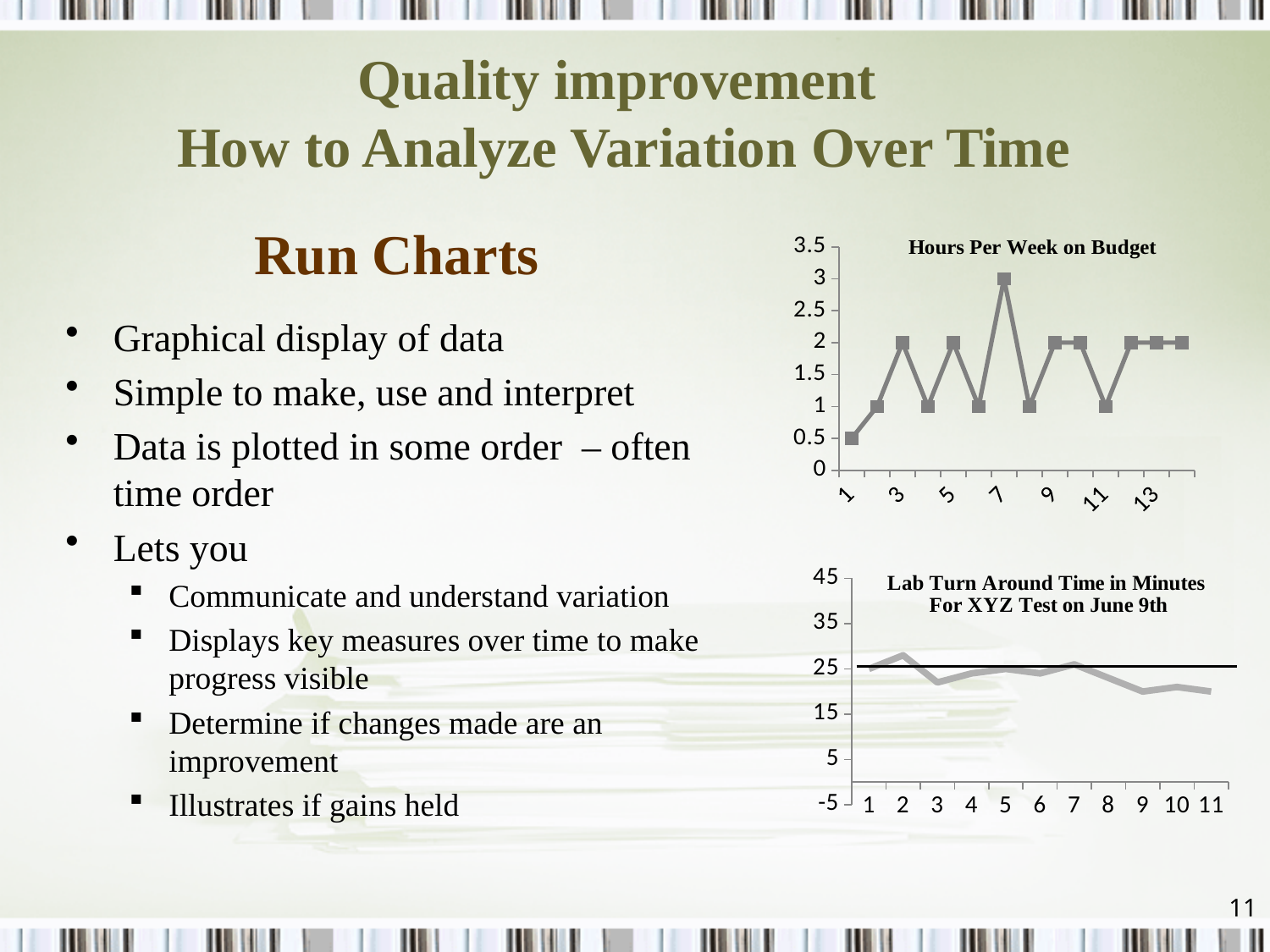
In the "Hours Per Week on Budget" chart, which point has the highest value? 7 In the "Lab Turn Around Time in Minutes For XYZ Test on June 9th" chart, is the value at point 9 greater or less than 25? less In the "Hours Per Week on Budget" chart, what is the value at point 3? 2 How many data points are plotted in the "Hours Per Week on Budget" chart? 14 In the "Hours Per Week on Budget" chart, is the value at point 5 larger or smaller than the value at point 6? larger In the "Lab Turn Around Time in Minutes For XYZ Test on June 9th" chart, which point has the highest value? 2 In the "Hours Per Week on Budget" chart, what is the difference between the value at point 7 and the value at point 8? 2 In the "Hours Per Week on Budget" chart, what is the value at point 7? 3 What type of chart is the "Hours Per Week on Budget" chart? line chart In the "Hours Per Week on Budget" chart, what is the value at point 1? 0.5 How many data points are plotted in the "Lab Turn Around Time in Minutes For XYZ Test on June 9th" chart? 11 In the "Hours Per Week on Budget" chart, which point has the lowest value? 1